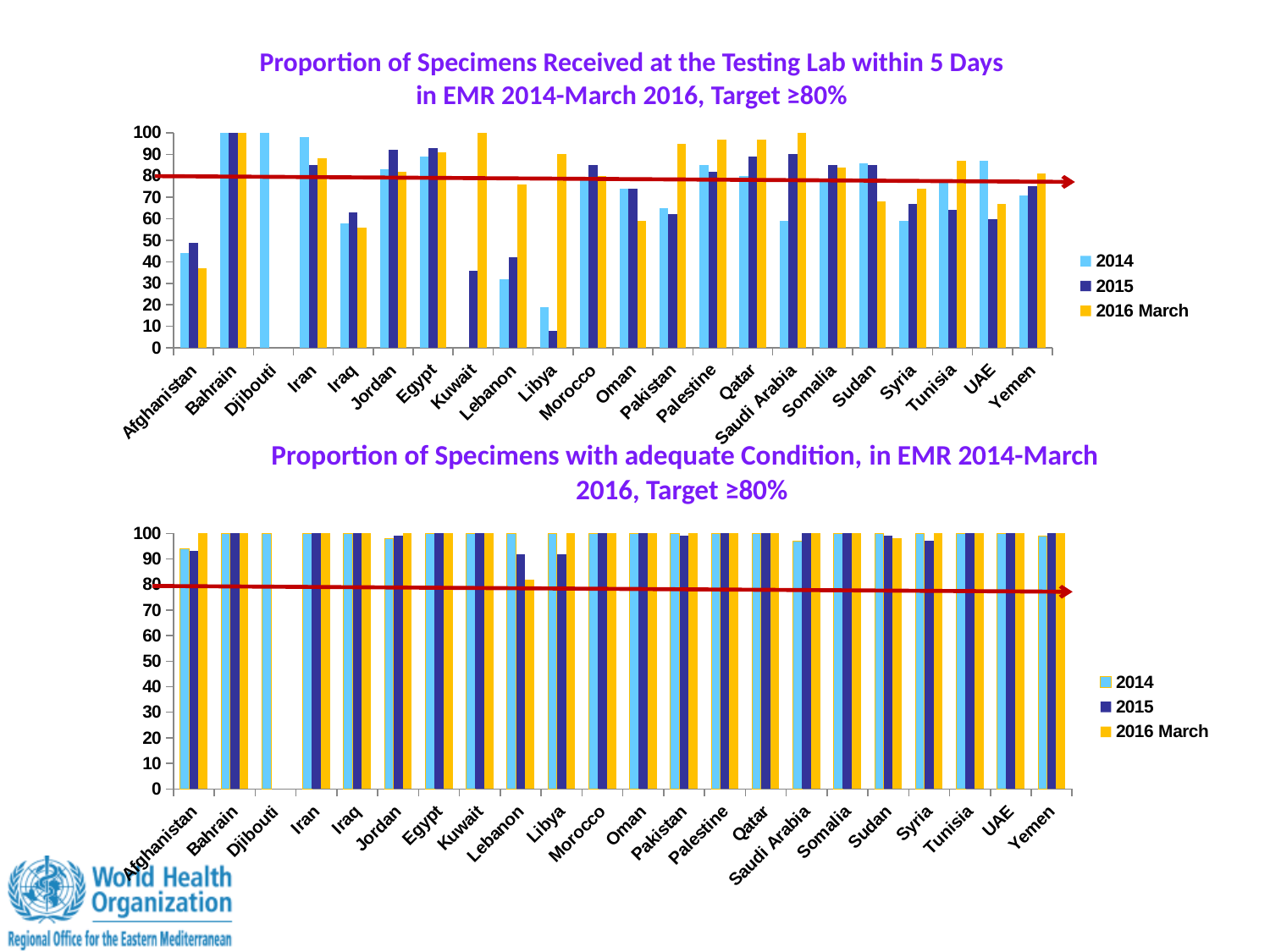
In the top chart, which is larger for Kuwait: the 2015 value or the 2016 March value? 2016 March What target value is stated in the title of the bottom chart? ≥80% In the top chart, is the 2016 March value for Iraq greater or less than 60? less In the bottom chart, is the 2016 March value for Lebanon greater or less than 90? less In the top chart, how many series does the legend list? 3 In the top chart, what is the 2016 March value for Kuwait? 100 What type of chart is the top chart, 'Proportion of Specimens Received at the Testing Lab within 5 Days'? Bar chart In the bottom chart, 'Proportion of Specimens with adequate Condition', which country has the lowest 2016 March value? Lebanon In the top chart, how many countries are shown on the x axis? 22 In the top chart, which country has the lowest 2015 value? Libya In the top chart, what is the 2016 March value for Bahrain? 100 In the top chart, is the 2014 value for Afghanistan greater or less than 50? less